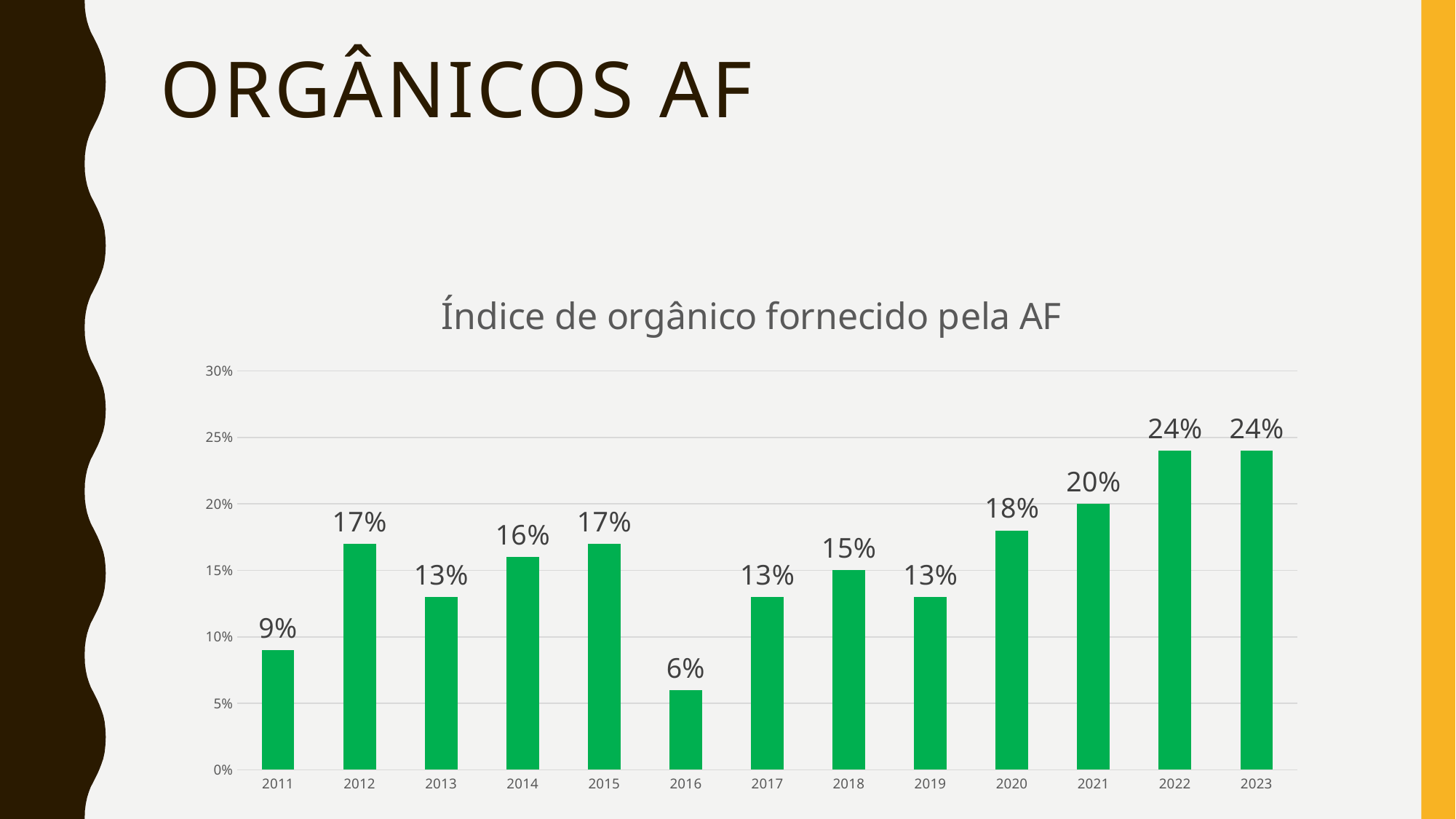
What is the difference between the values for 2023 and 2011? 15% What is the difference between the values for 2015 and 2016? 11% Which is larger, the value for 2014 or the value for 2018? 2014 What is the value for 2011? 9% What is the highest value shown in the chart? 24% Which year has the lowest value? 2016 What kind of chart is shown on the slide? Bar chart What is the value for 2016? 6% What is the value for 2020? 18% What is the title of the chart? Índice de orgânico fornecido pela AF Is the value for 2021 greater or less than 15%? greater How many years are shown on the x axis? 13